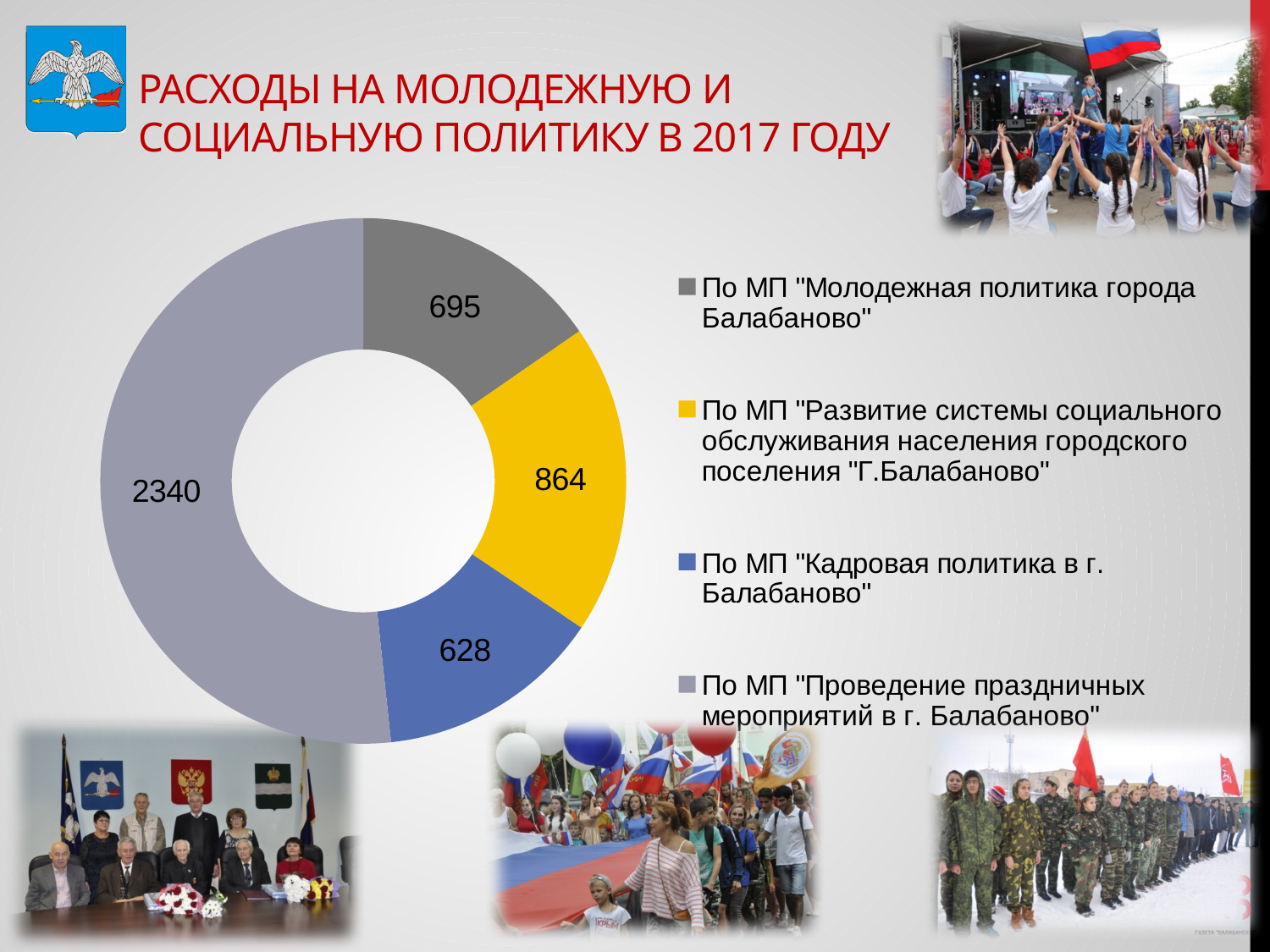
What is the value for the slice "По МП "Развитие системы социального обслуживания населения городского поселения "Г.Балабаново""? 864 Which is larger: the value for "Развитие системы социального обслуживания" or the value for "Молодежная политика города Балабаново"? Развитие системы социального обслуживания What is the difference between the values for "Молодежная политика города Балабаново" and "Кадровая политика в г. Балабаново"? 67 Which category has the largest value in the chart? По МП "Проведение праздничных мероприятий в г. Балабаново" What is the value for the slice "По МП "Проведение праздничных мероприятий в г. Балабаново""? 2340 What is the difference between the values for "Проведение праздничных мероприятий" and "Развитие системы социального обслуживания"? 1476 How many categories does the chart show? 4 What colour is the slice for "По МП "Кадровая политика в г. Балабаново""? blue What is the value for the slice "По МП "Кадровая политика в г. Балабаново""? 628 What kind of chart is shown on the slide? doughnut (pie) chart Which category has the smallest value in the chart? По МП "Кадровая политика в г. Балабаново" What is the value for the slice "По МП "Молодежная политика города Балабаново""? 695